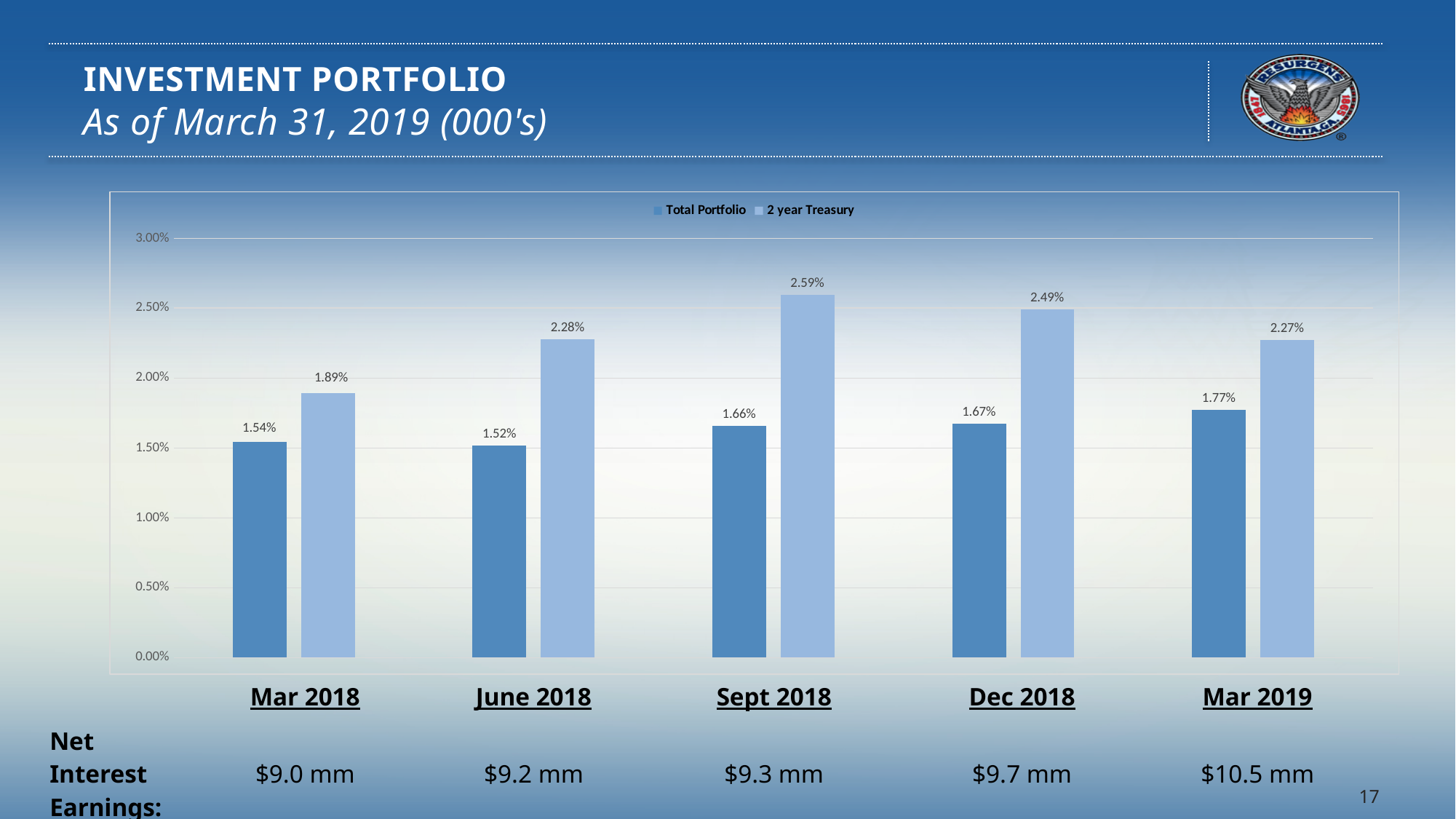
Which is larger in Mar 2018, the Total Portfolio value or the 2 year Treasury value? 2 year Treasury How many periods are shown on the x axis of the chart? 5 In which period is the Total Portfolio value lowest? June 2018 What is the 2 year Treasury value for June 2018? 2.28% What is the difference between the 2 year Treasury and Total Portfolio values in Dec 2018? 0.82% In which period is the 2 year Treasury value highest? Sept 2018 Is the 2 year Treasury value for Mar 2019 greater or less than 2.00%? greater How many series does the chart legend list? 2 What is the Total Portfolio value for Mar 2019? 1.77% What is the Total Portfolio value for Sept 2018? 1.66% What kind of chart is shown on the slide? Bar chart What are the two series named in the chart legend? Total Portfolio and 2 year Treasury